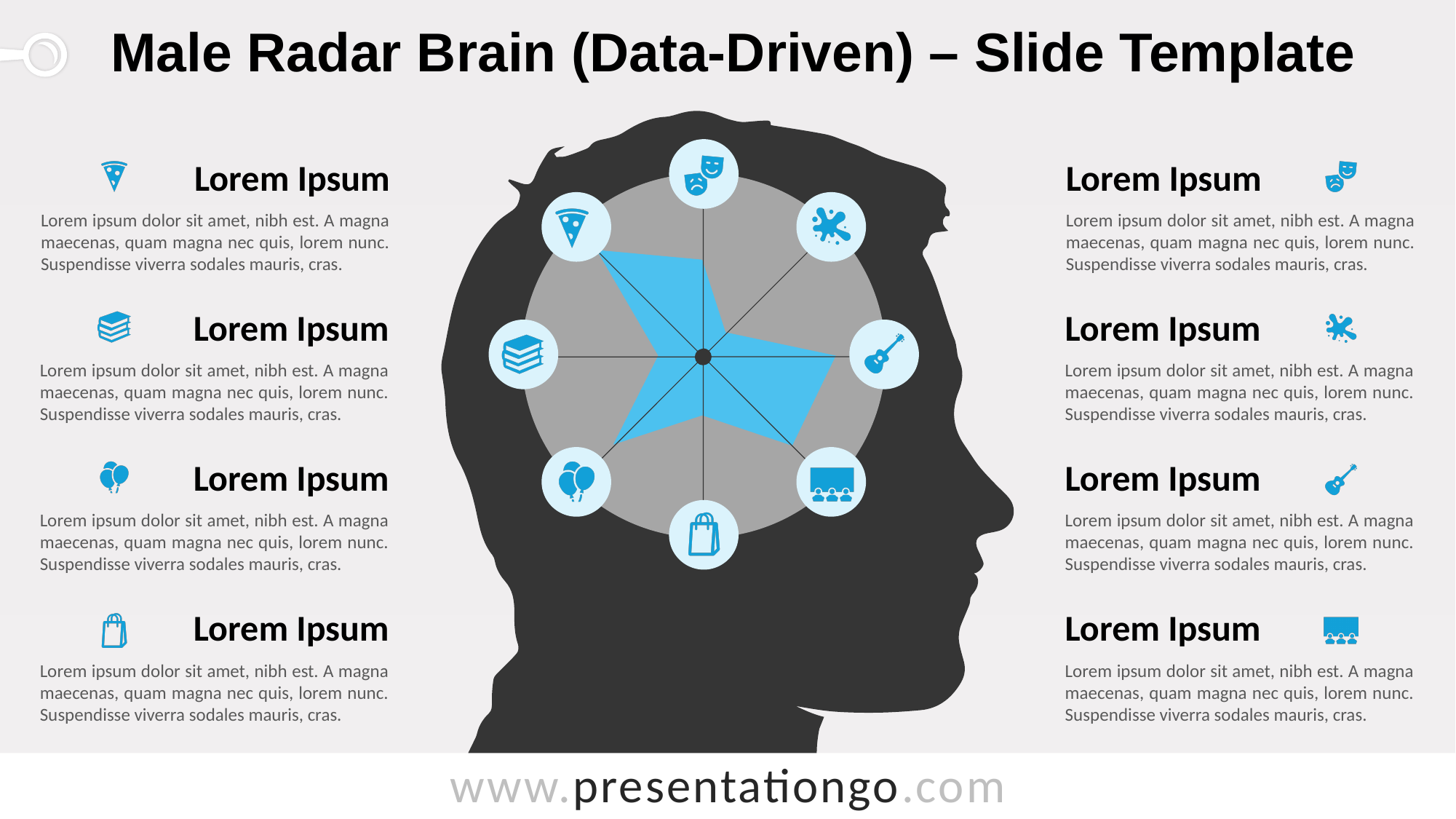
What kind of chart is shown inside the head silhouette? Radar chart How many axes (categories) does the radar chart have? 8 What colour is the filled data area of the radar chart? Blue What is the title of the slide containing the radar chart? Male Radar Brain (Data-Driven) – Slide Template How many data series are plotted on the radar chart? 1 On the radar chart, is the value on the shopping-bag-icon axis larger or smaller than the value on the audience-icon axis? Smaller On the radar chart, is the value on the pizza-icon axis larger or smaller than the value on the paint-splat-icon axis? Larger On the radar chart, is the value on the guitar-icon axis larger or smaller than the value on the books-icon axis? Larger